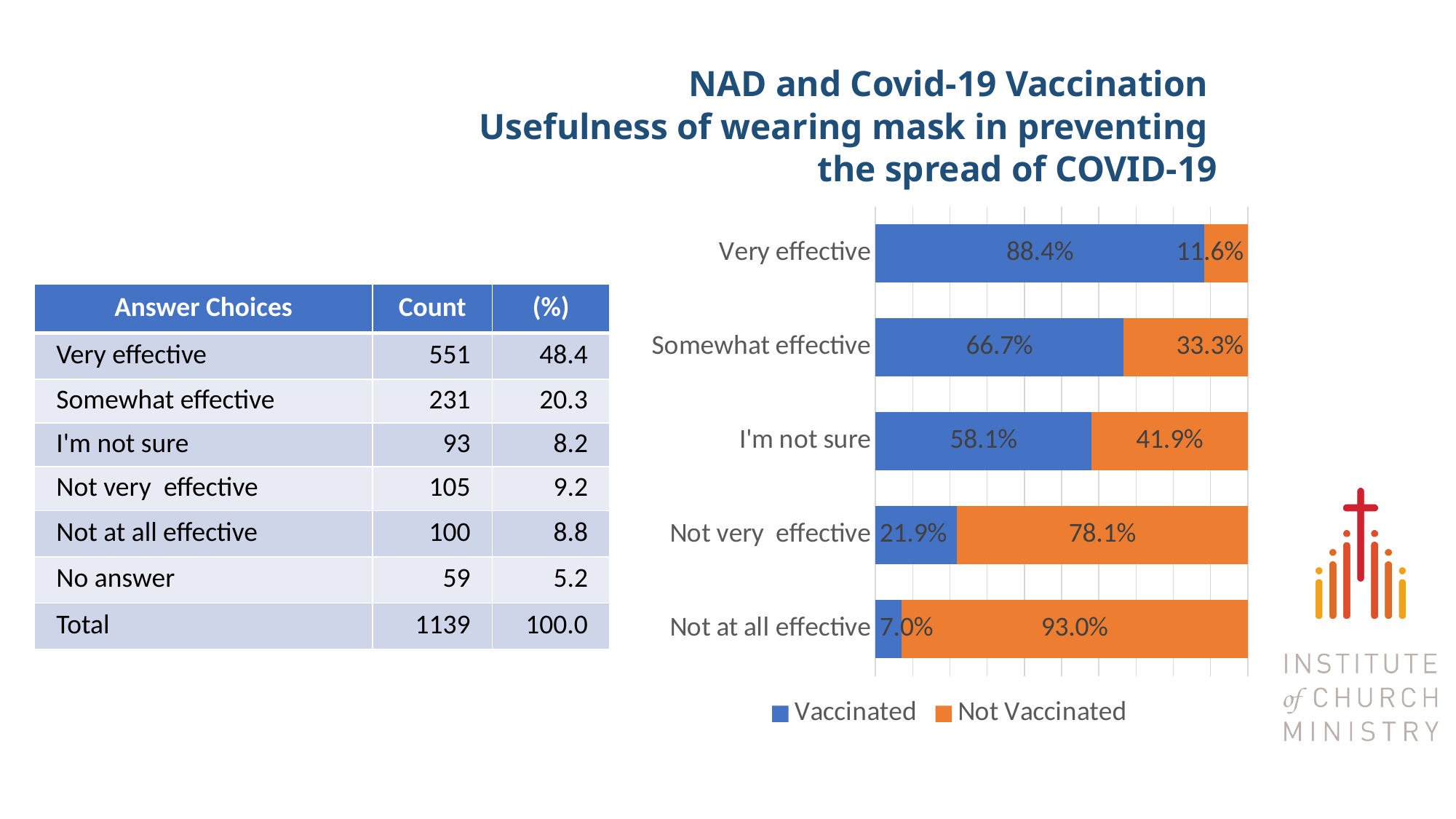
What is the Vaccinated value for "Not at all effective"? 7.0% For "I'm not sure", which is larger: the Vaccinated share or the Not Vaccinated share? Vaccinated What is the difference between the Vaccinated and Not Vaccinated shares for "Not very effective"? 56.2% How many categories are shown on the chart? 5 What is the Not Vaccinated value for "Somewhat effective"? 33.3% Which colour represents the Not Vaccinated series? Orange How many series does the legend list? 2 What is the Not Vaccinated share for the "I'm not sure" category? 41.9% What percentage of respondents who said masks are "Very effective" are Vaccinated? 88.4% Which category has the highest Not Vaccinated share? Not at all effective Which category has the lowest Vaccinated share? Not at all effective What kind of chart is shown on the slide? Stacked bar chart